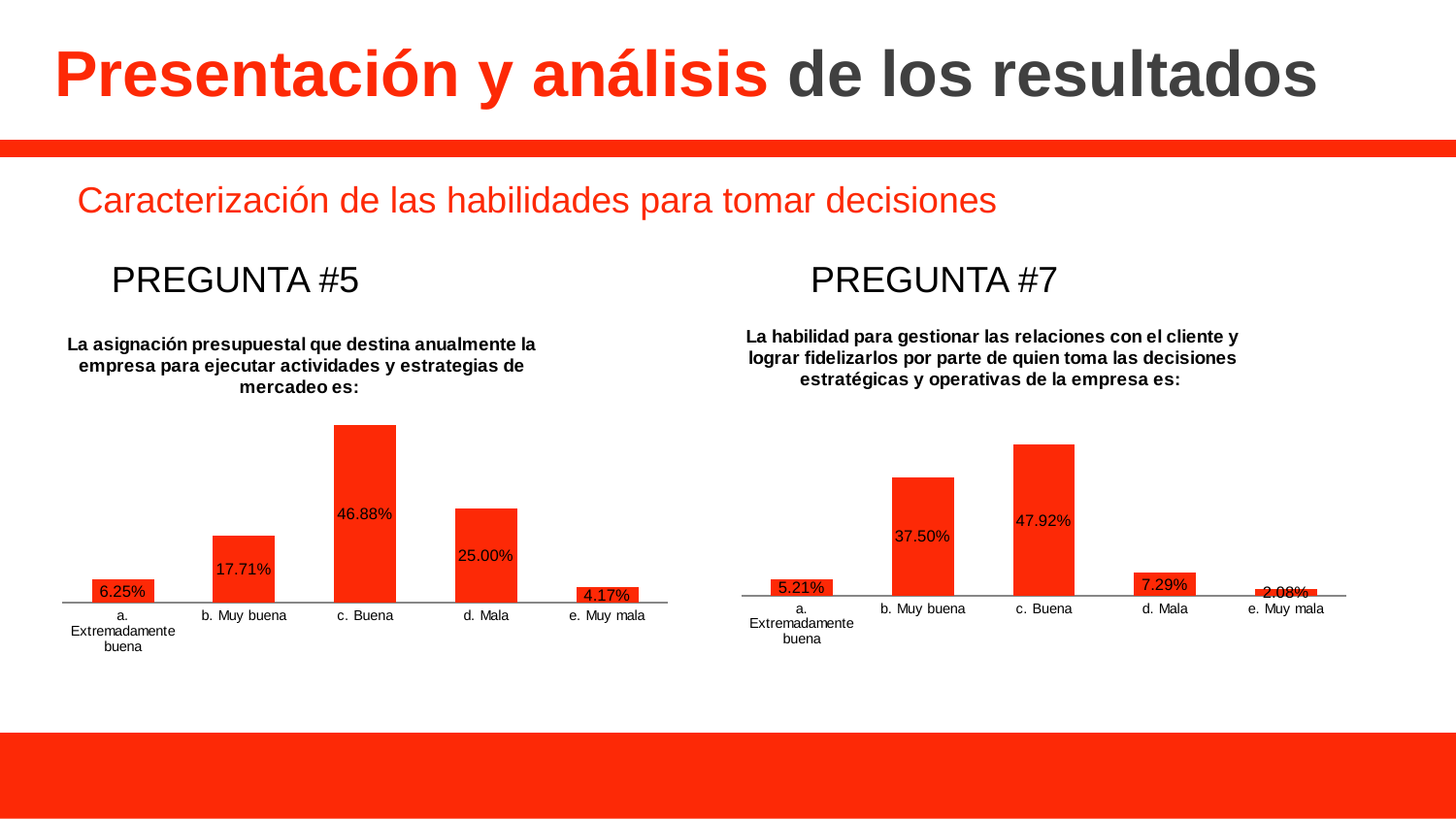
What colour are the bars in the PREGUNTA #5 chart? Red In the PREGUNTA #7 chart, which category has the lowest value? e. Muy mala How many categories does the PREGUNTA #5 chart show? 5 In the PREGUNTA #5 chart, what is the value for c. Buena? 46.88% In the PREGUNTA #5 chart, what is the difference between c. Buena and d. Mala? 21.88% In the PREGUNTA #5 chart, what is the value for d. Mala? 25.00% In the PREGUNTA #5 chart, which category has the highest value? c. Buena In the PREGUNTA #7 chart, what is the value for e. Muy mala? 2.08% In the PREGUNTA #7 chart, what is the value for b. Muy buena? 37.50% In the PREGUNTA #7 chart, which is larger: a. Extremadamente buena or d. Mala? d. Mala What kind of chart is the PREGUNTA #7 chart? Bar chart In the PREGUNTA #7 chart, what is the difference between c. Buena and b. Muy buena? 10.42%